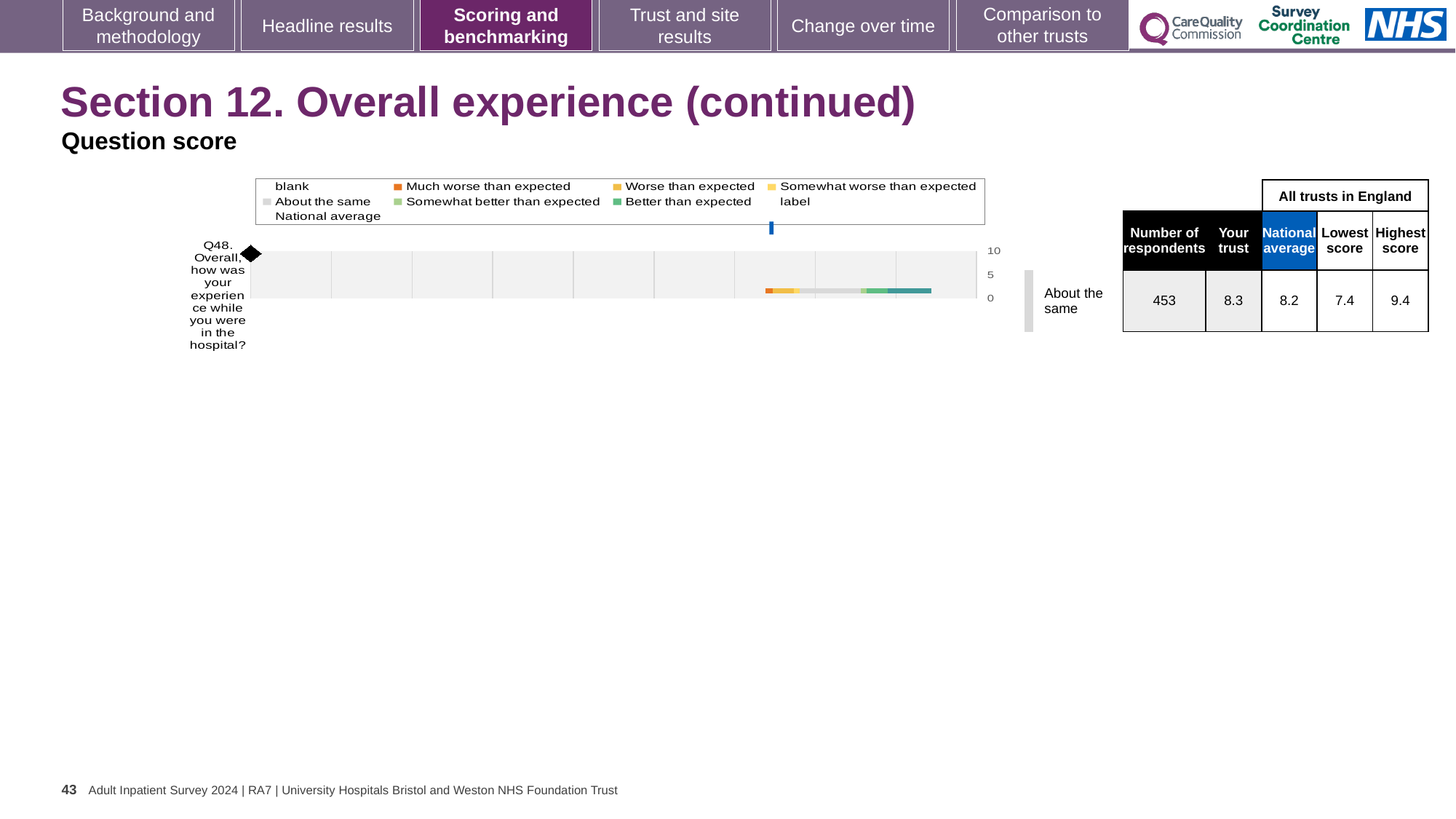
How many survey questions are plotted on the chart? 1 What is the difference between the highest and lowest scores for Q48? 2.0 What is the national average score for Q48? 8.2 Which question is plotted on the chart? Q48. Overall, how was your experience while you were in the hospital? What is the number of respondents for Q48? 453 By how much does the 'Your trust' score for Q48 exceed the national average? 0.1 What is the 'Your trust' score for Q48? 8.3 What is the highest score among all trusts in England for Q48? 9.4 What kind of chart is used to show the Q48 question score? bar chart Which is larger for Q48, the 'Your trust' score or the national average? Your trust Which benchmark category is Q48 placed in? About the same What is the lowest score among all trusts in England for Q48? 7.4